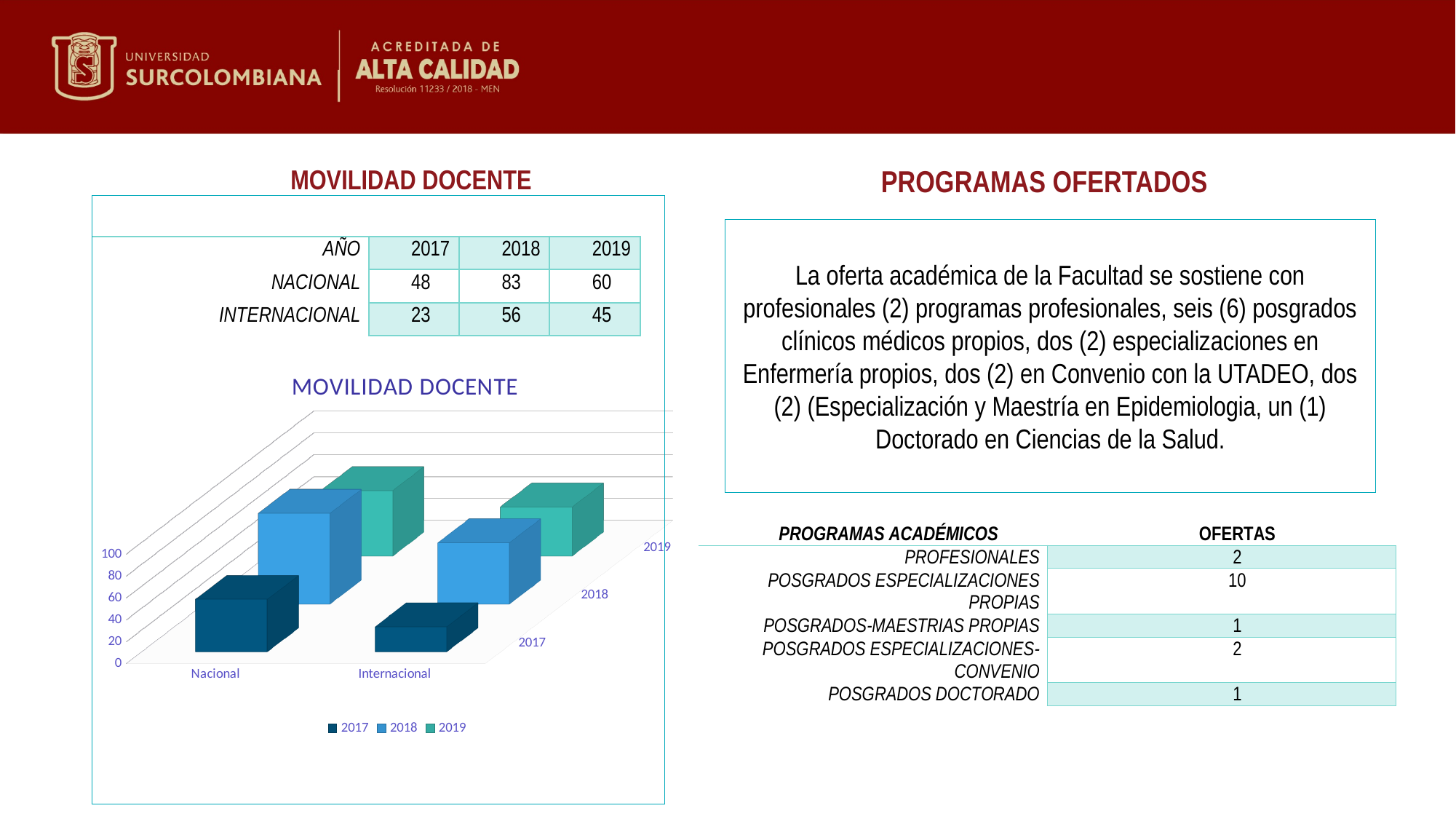
How many categories are shown on the x axis of the MOVILIDAD DOCENTE chart? 2 In the MOVILIDAD DOCENTE chart, what is the difference between the Nacional and Internacional values for 2018? 27 What is the value for Internacional in 2017 in the MOVILIDAD DOCENTE chart? 23 What kind of chart is the MOVILIDAD DOCENTE chart? bar chart Which series is shown in the darkest blue in the MOVILIDAD DOCENTE chart? 2017 In the MOVILIDAD DOCENTE chart, is the value for Nacional in 2018 greater or less than 80? greater What is the value for Nacional in 2018 in the MOVILIDAD DOCENTE chart? 83 How many series does the legend of the MOVILIDAD DOCENTE chart list? 3 What is the value for Internacional in 2019 in the MOVILIDAD DOCENTE chart? 45 In the MOVILIDAD DOCENTE chart, which is larger: Nacional in 2017 or Internacional in 2019? Nacional in 2017 In the MOVILIDAD DOCENTE chart, which year has the highest value for Nacional? 2018 In the MOVILIDAD DOCENTE chart, which year has the lowest value for Internacional? 2017